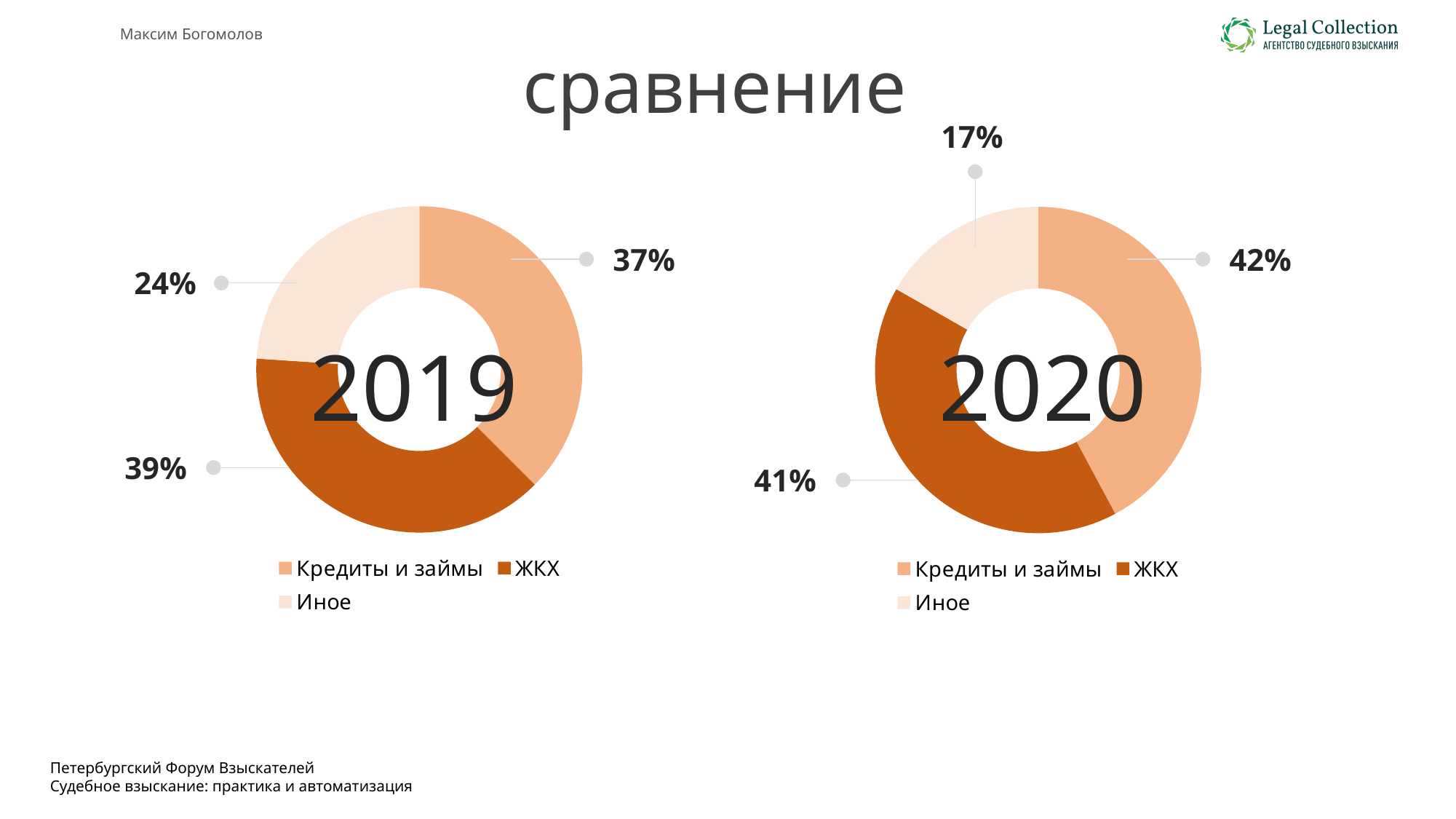
How many categories does the legend of the 2019 chart list? 3 In the 2020 chart, which category has the smallest share? Иное Which is larger in the 2020 chart: the share of Кредиты и займы or the share of ЖКХ? Кредиты и займы What type of chart is used for the 2020 data? Doughnut (pie) chart In the 2019 chart, which category has the largest share? ЖКХ In the 2019 chart, what share is shown for ЖКХ? 39% In the 2020 chart, what share is shown for ЖКХ? 41% In the 2020 chart, what share is shown for Кредиты и займы? 42% In the 2019 chart, what share is shown for Кредиты и займы? 37% In the 2019 chart, what share is shown for Иное? 24% In the 2020 chart, what share is shown for Иное? 17% What is the difference between the share of Иное in the 2019 chart and in the 2020 chart? 7%